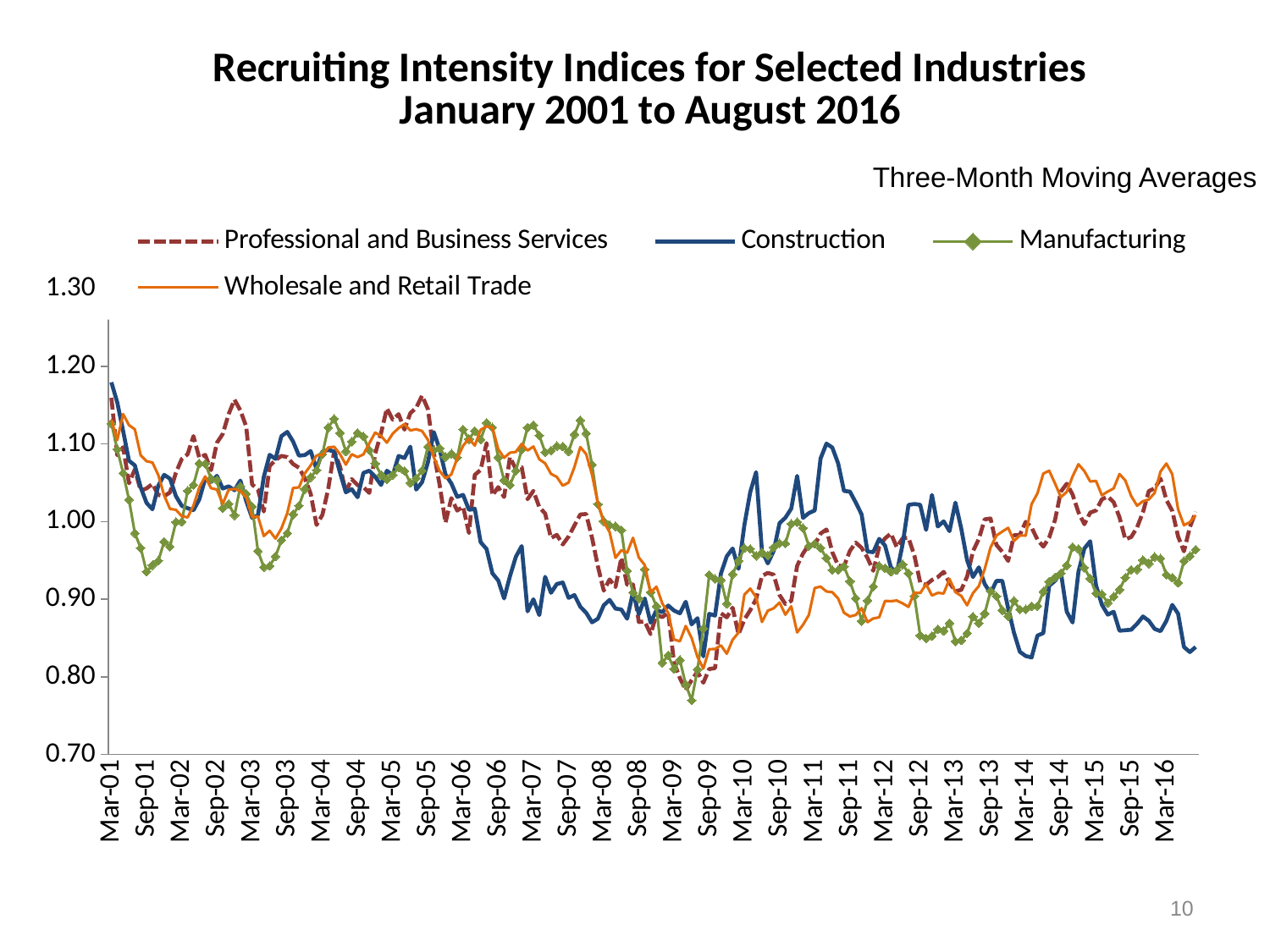
Which series is drawn with a dashed line? Professional and Business Services What kind of chart is shown on the slide? line chart What is the title of the chart? Recruiting Intensity Indices for Selected Industries January 2001 to August 2016 At Mar-16, which series is higher: Wholesale and Retail Trade or Construction? Wholesale and Retail Trade How many series does the legend list? 4 Is the value for Wholesale and Retail Trade at Sep-14 greater or less than 1.00? greater Is the value for Construction at Mar-01 greater or less than 1.10? greater Is the value for Construction at the end of the series (after Mar-16) greater or less than 0.90? less Which series is the lowest at Mar-16? Construction Does the Construction series rise or fall between Mar-06 and Mar-09? fall At Sep-07, which series is higher: Manufacturing or Construction? Manufacturing